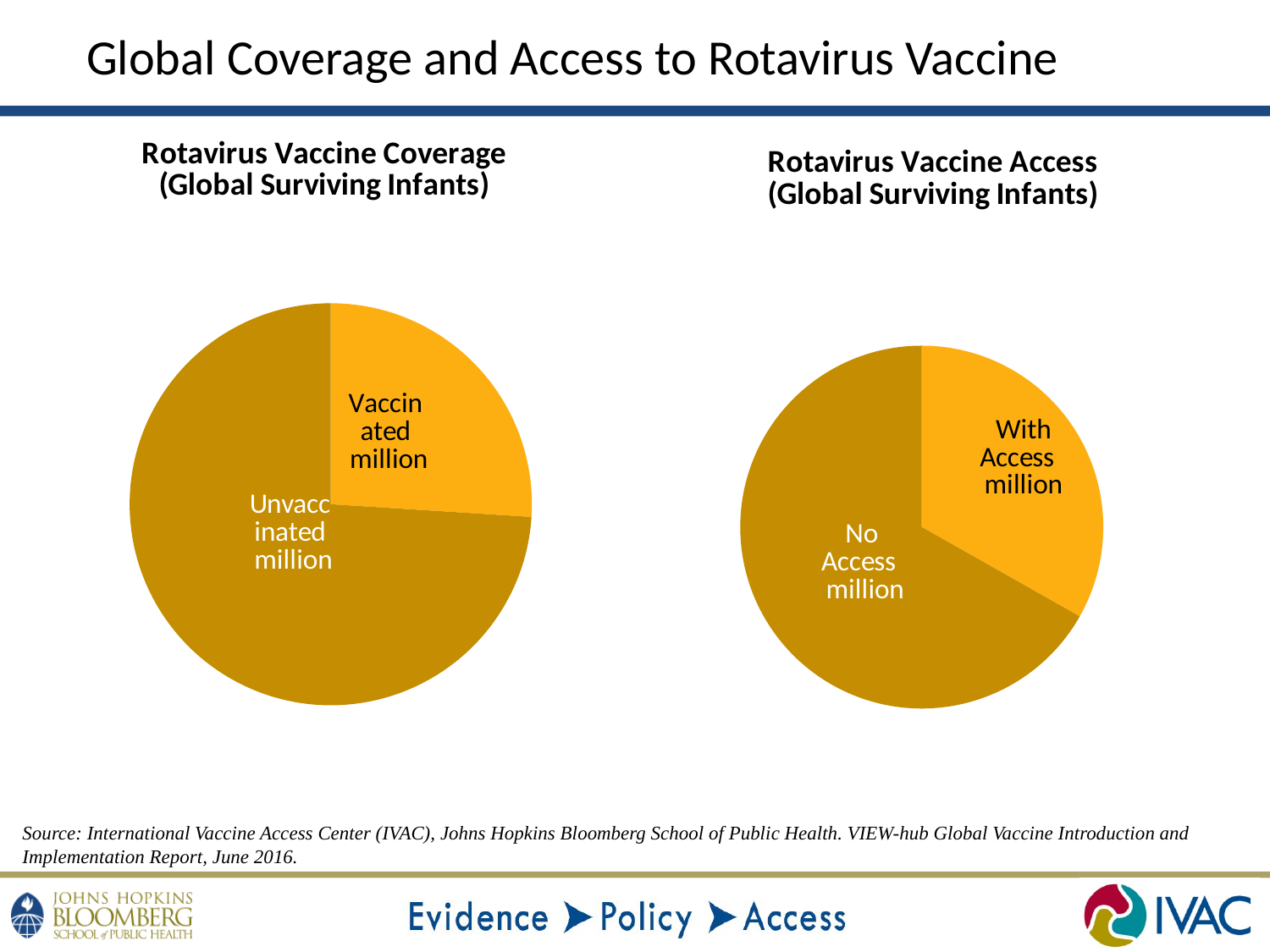
In the "Rotavirus Vaccine Access" pie chart on the right, which slice is the largest? No Access What is the title of the pie chart on the left side of the slide? Rotavirus Vaccine Coverage (Global Surviving Infants) What kind of chart is the "Rotavirus Vaccine Coverage (Global Surviving Infants)" chart on the left? Pie chart In the "Rotavirus Vaccine Coverage" pie chart on the left, how many slices are there? 2 In the "Rotavirus Vaccine Access" pie chart on the right, which slice is the smallest? With Access In the "Rotavirus Vaccine Coverage" pie chart on the left, which slice is the largest? Unvaccinated What kind of chart is the "Rotavirus Vaccine Access (Global Surviving Infants)" chart on the right? Pie chart In the "Rotavirus Vaccine Coverage" pie chart on the left, which is larger: the Vaccinated slice or the Unvaccinated slice? Unvaccinated What is the title of the pie chart on the right side of the slide? Rotavirus Vaccine Access (Global Surviving Infants) In the "Rotavirus Vaccine Coverage" pie chart on the left, which slice is the smallest? Vaccinated In the "Rotavirus Vaccine Access" pie chart on the right, which is larger: the With Access slice or the No Access slice? No Access In the "Rotavirus Vaccine Access" pie chart on the right, how many slices are there? 2